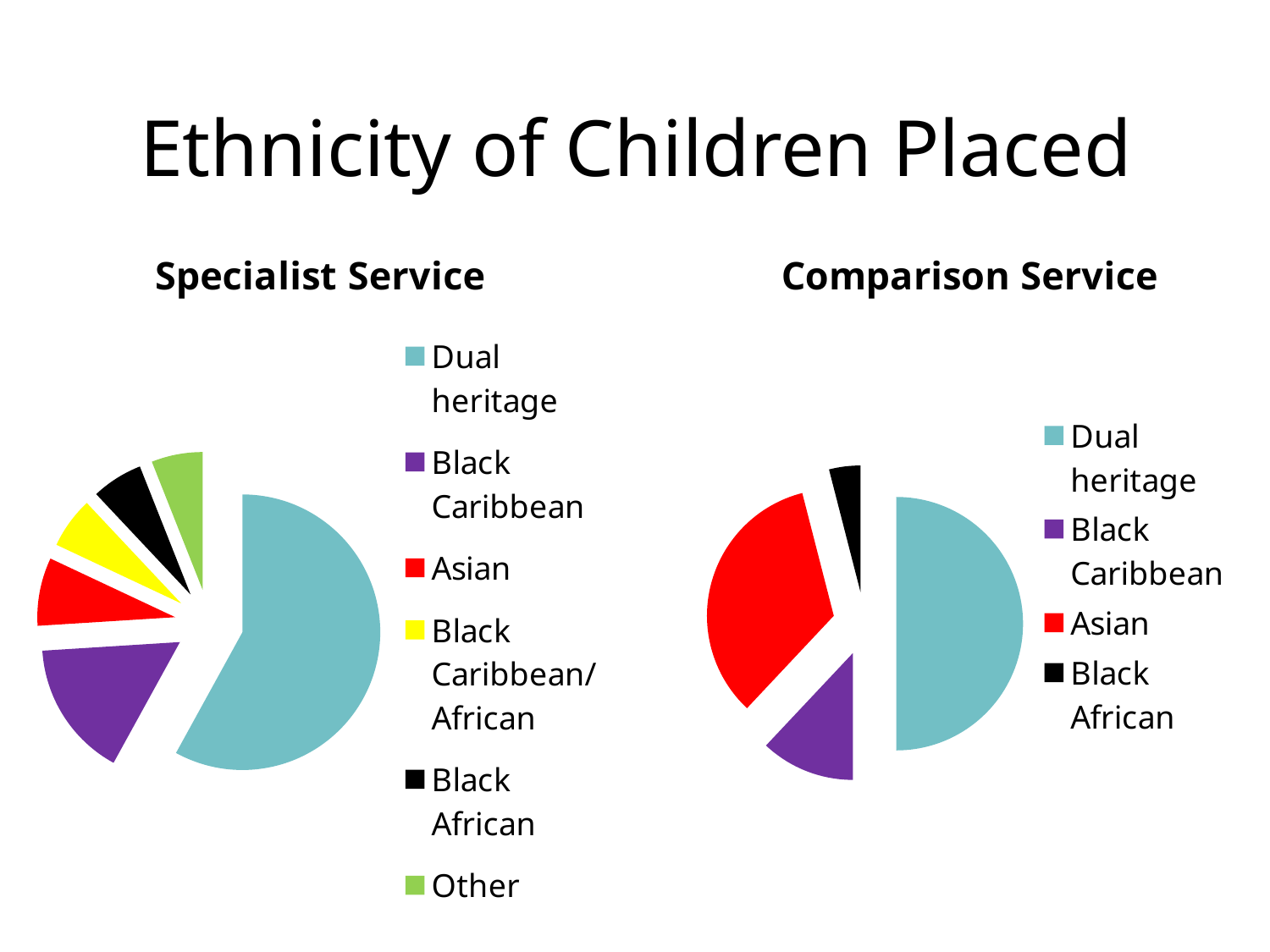
In the Specialist Service chart, how many slices does the pie have? 6 In the Specialist Service chart, which legend entry is shown in green? Other In the Comparison Service chart, how many slices does the pie have? 4 In the Comparison Service chart, which ethnicity has the largest slice? Dual heritage What kind of chart is the Comparison Service chart? pie chart In the Specialist Service chart, which ethnicity has the largest slice? Dual heritage Which legend entry appears in the Specialist Service chart but not in the Comparison Service chart, apart from Other? Black Caribbean/African In the Comparison Service chart, which ethnicity has the smallest slice? Black African What kind of chart is the Specialist Service chart? pie chart In the Comparison Service chart, which slice is larger, Asian or Black Caribbean? Asian In the Specialist Service chart, which slice is larger, Black Caribbean or Asian? Black Caribbean In the Specialist Service chart, which slice is larger, Dual heritage or Black Caribbean? Dual heritage